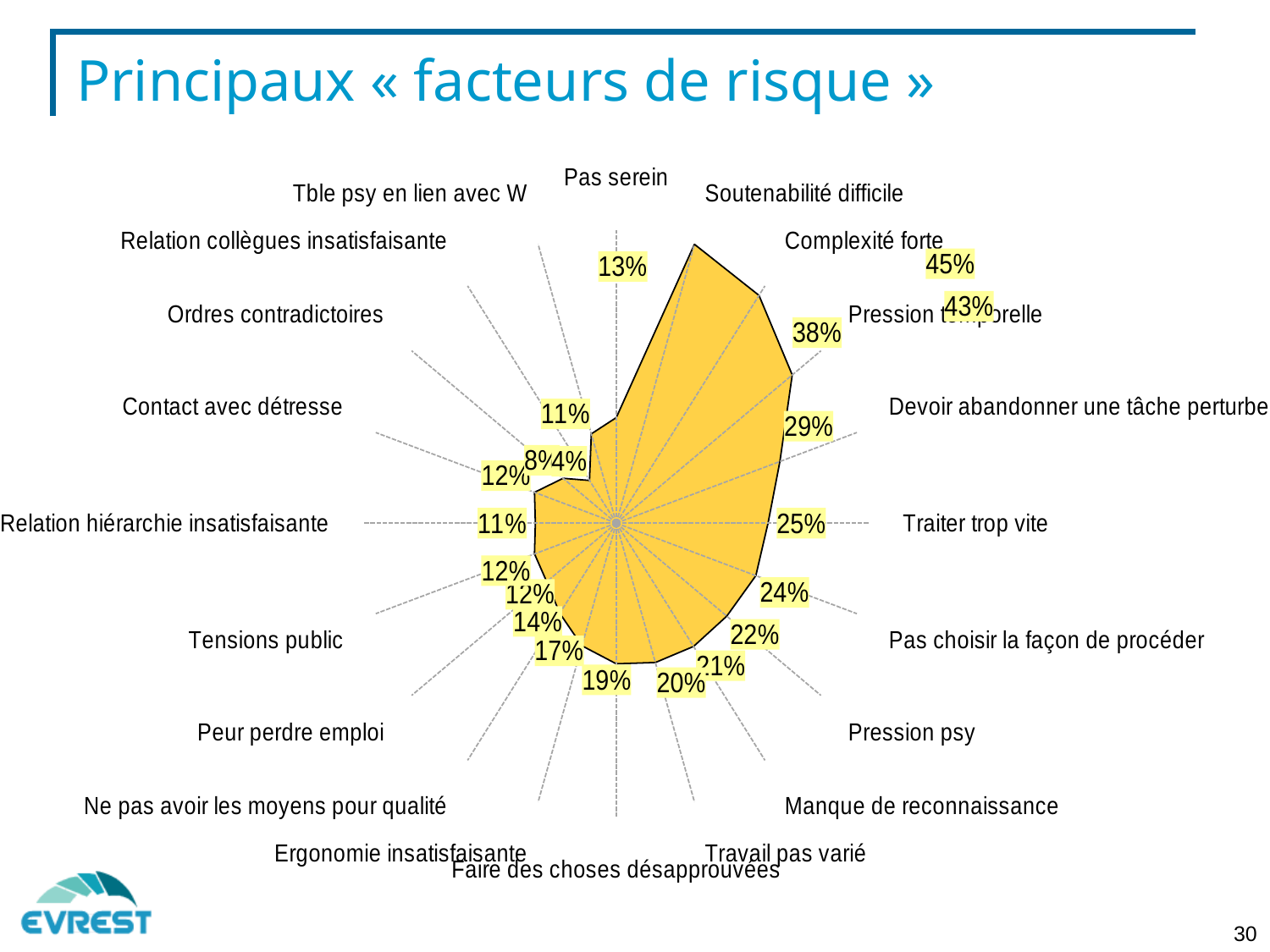
How many risk factors (axes) are plotted on the radar chart? 20 What is the value for Relation hiérarchie insatisfaisante? 11% What is the value for Complexité forte? 43% What is the value for Traiter trop vite? 25% What is the value for Pas serein? 13% What is the difference between the values for Soutenabilité difficile and Traiter trop vite? 20 percentage points Which is larger, the value for Pression temporelle or the value for Traiter trop vite? Pression temporelle Which risk factor has the highest value? Soutenabilité difficile What is the value for Soutenabilité difficile? 45% What type of chart is shown on the slide? Radar chart Which risk factor has the lowest value? Relation collègues insatisfaisante What is the value for Pression temporelle? 38%